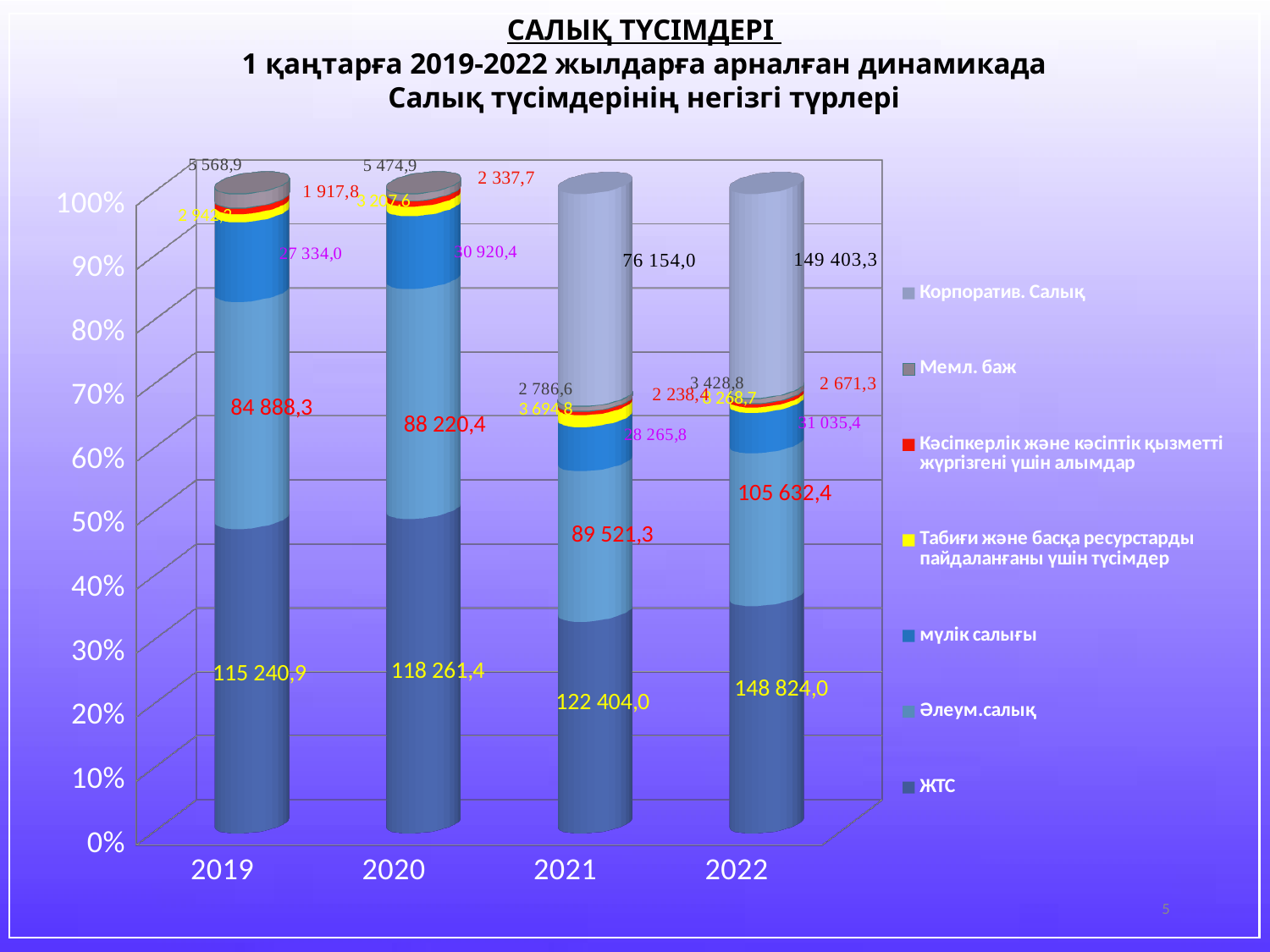
What is the value of Корпоратив. Салық for 2021? 76 154,0 How many series does the legend list? 7 In which year is the ЖТС value highest? 2022 What is the difference between the ЖТС values for 2022 and 2021? 26 420,0 What is the value of ЖТС for 2022? 148 824,0 What is the value of Әлеум.салық for 2020? 88 220,4 What is the value of Мемл. баж for 2022? 3 428,8 How many years are shown on the x axis? 4 What is the value of мүлік салығы for 2019? 27 334,0 Which is larger: Әлеум.салық in 2019 or in 2021? 2021 What kind of chart is shown on the slide? Stacked bar chart In which year is the Мемл. баж value lowest? 2021